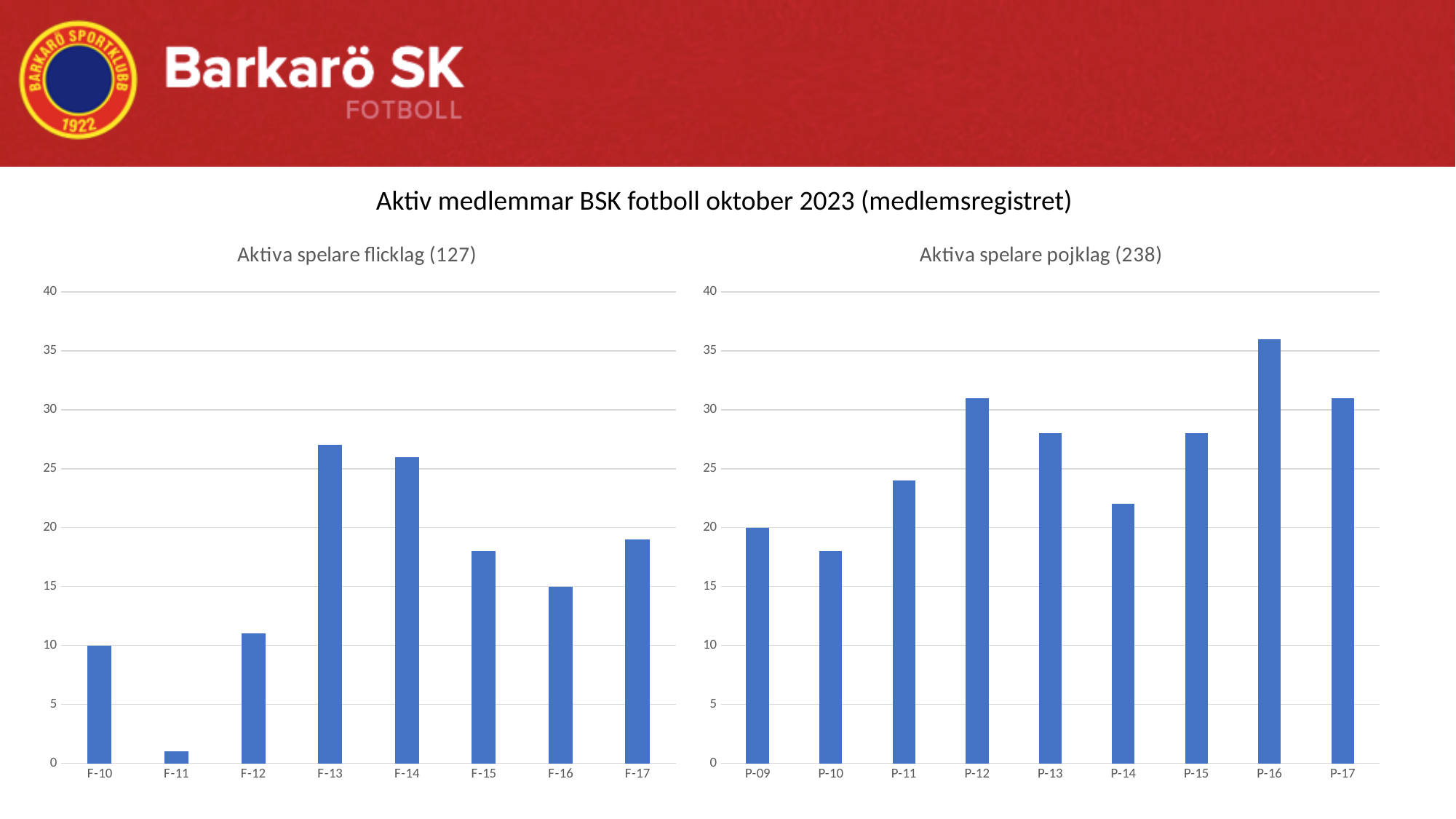
In the 'Aktiva spelare pojklag (238)' chart, which category has the lowest value? P-10 In the 'Aktiva spelare flicklag (127)' chart, is the value for F-13 greater or less than 25? greater What kind of chart is the 'Aktiva spelare flicklag (127)' chart? bar chart In the 'Aktiva spelare pojklag (238)' chart, what is the value for P-09? 20 How many categories are shown in the 'Aktiva spelare flicklag (127)' chart? 8 In the 'Aktiva spelare pojklag (238)' chart, is the value for P-16 greater or less than 35? greater In the 'Aktiva spelare flicklag (127)' chart, what is the value for F-10? 10 In the 'Aktiva spelare flicklag (127)' chart, which category has the lowest value? F-11 In the 'Aktiva spelare pojklag (238)' chart, is the value for P-14 greater or less than 25? less How many categories are shown in the 'Aktiva spelare pojklag (238)' chart? 9 In the 'Aktiva spelare flicklag (127)' chart, which is larger, the value for F-13 or the value for F-16? F-13 In the 'Aktiva spelare pojklag (238)' chart, which category has the highest value? P-16